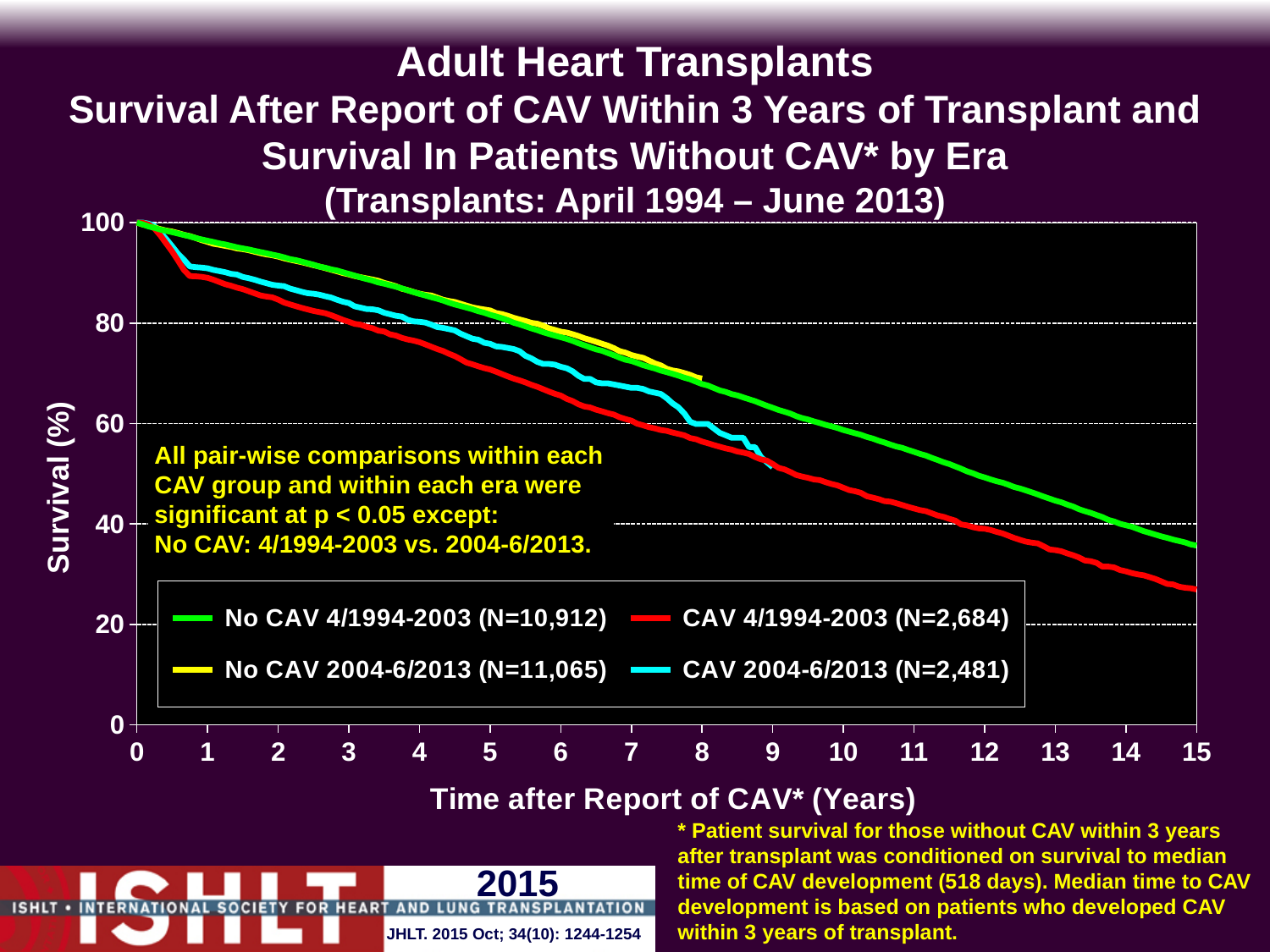
Is the survival value for CAV 2004-6/2013 at 9 years greater or less than 60? less How many series does the legend list? 4 Is the survival value for CAV 4/1994-2003 at 5 years greater or less than 80? less Is the survival value for CAV 4/1994-2003 at 15 years greater or less than 20? greater What is the label of the y axis? Survival (%) At 5 years, which series has higher survival: No CAV 4/1994-2003 or CAV 4/1994-2003? No CAV 4/1994-2003 What is the N value shown in the legend for No CAV 2004-6/2013? N=11,065 What kind of chart is shown on the slide? line chart Do the survival curves rise or fall as time after report of CAV increases? fall Which series has the lowest survival at 5 years? CAV 4/1994-2003